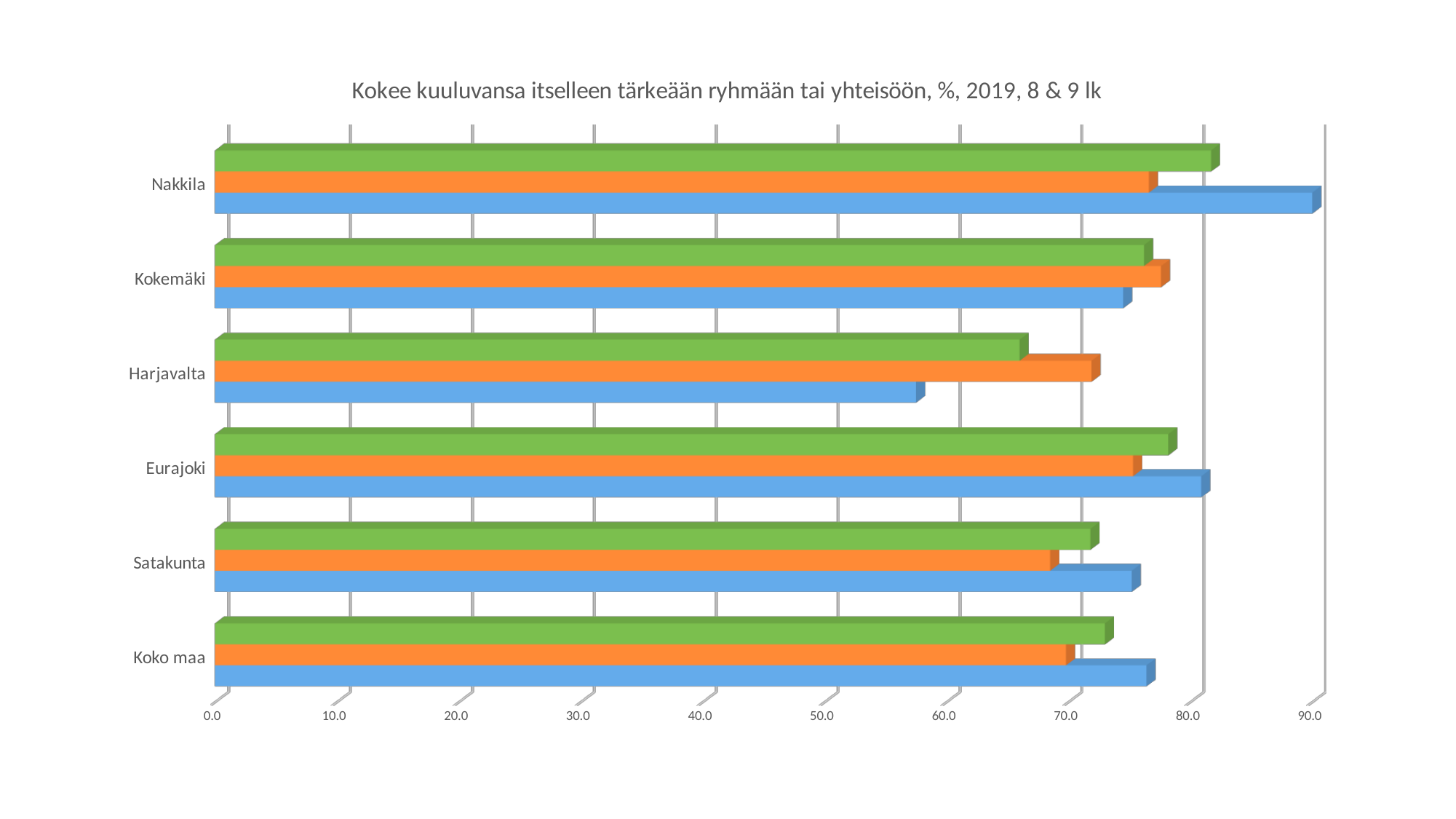
How many bars are plotted for each category in the chart? 3 Is the value of the blue bar for Nakkila greater or less than 80? greater Is the value of the blue bar for Koko maa greater or less than 70? greater How many categories are shown on the vertical axis of the chart? 6 What kind of chart is shown on the slide? bar chart Which category has the highest value among the blue bars? Nakkila Which category has the lowest value among the blue bars? Harjavalta Is the value of the orange bar for Kokemäki greater or less than 80? less What is the title of the chart? Kokee kuuluvansa itselleen tärkeään ryhmään tai yhteisöön, %, 2019, 8 & 9 lk For Harjavalta, which bar is larger, the orange bar or the blue bar? orange